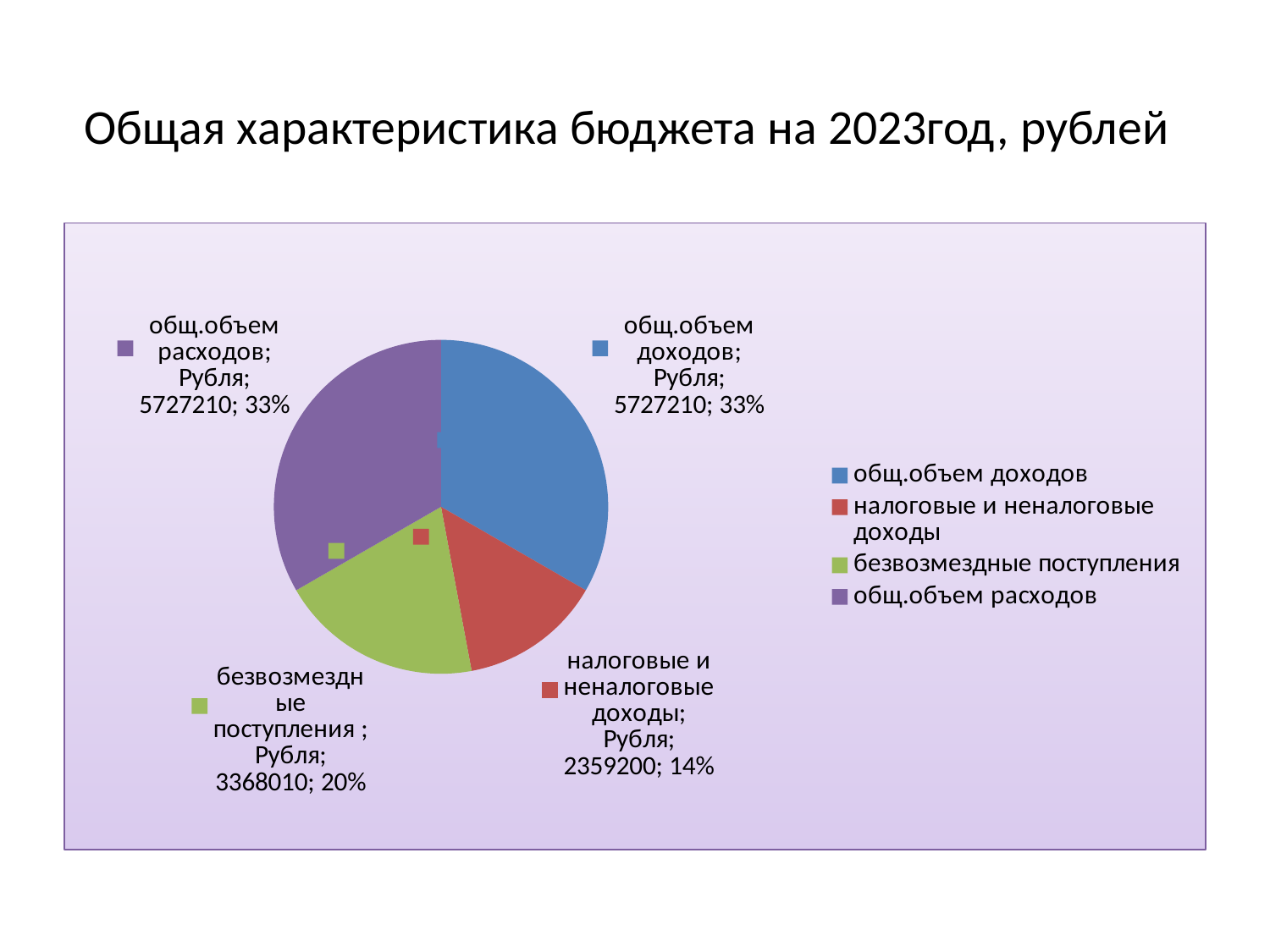
What is the value for общ.объем расходов? 5727210 What is the value for налоговые и неналоговые доходы? 2359200 What kind of chart is shown on the slide? pie chart What is the value for безвозмездные поступления? 3368010 Which is larger: безвозмездные поступления or налоговые и неналоговые доходы? безвозмездные поступления What is the value for общ.объем доходов? 5727210 Which category has the smallest slice of the pie? налоговые и неналоговые доходы What share of the pie does налоговые и неналоговые доходы represent? 14% How many slices does the pie chart have? 4 What is the title of the slide? Общая характеристика бюджета на 2023год, рублей What is the difference between безвозмездные поступления and налоговые и неналоговые доходы? 1008810 What share of the pie does безвозмездные поступления represent? 20%